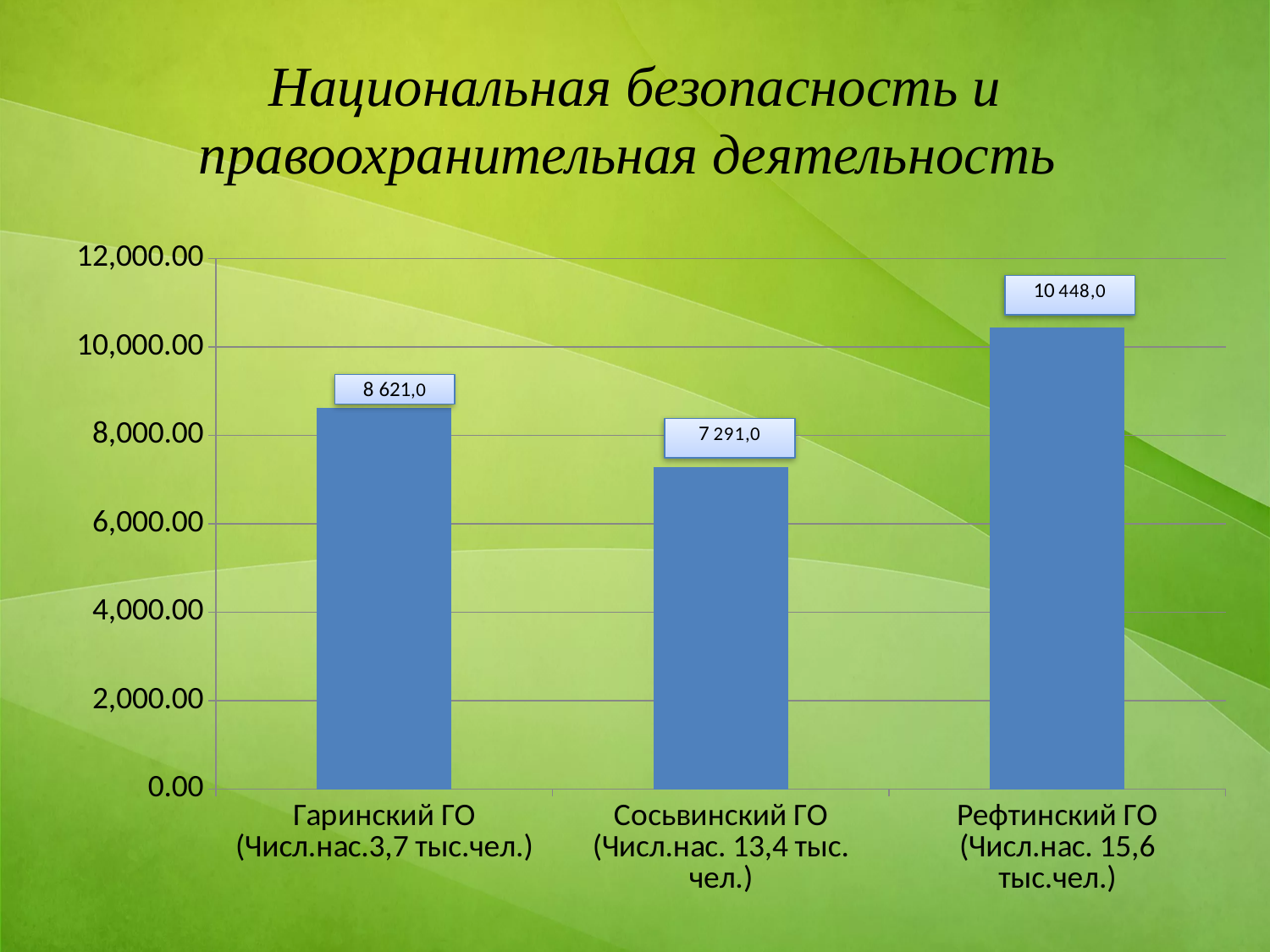
How many categories are shown in the chart? 3 Which category has the lowest value? Сосьвинский ГО What is the value for Гаринский ГО? 8 621,0 Which is larger, the value for Гаринский ГО or the value for Сосьвинский ГО? Гаринский ГО What is the difference between the values for Рефтинский ГО and Гаринский ГО? 1 827,0 What is the title of the slide? Национальная безопасность и правоохранительная деятельность What kind of chart is shown on the slide? bar chart What is the value for Рефтинский ГО? 10 448,0 Which category has the highest value? Рефтинский ГО What is the value for Сосьвинский ГО? 7 291,0 Is the value for Рефтинский ГО greater or less than 10,000.00? greater What is the difference between the values for Гаринский ГО and Сосьвинский ГО? 1 330,0